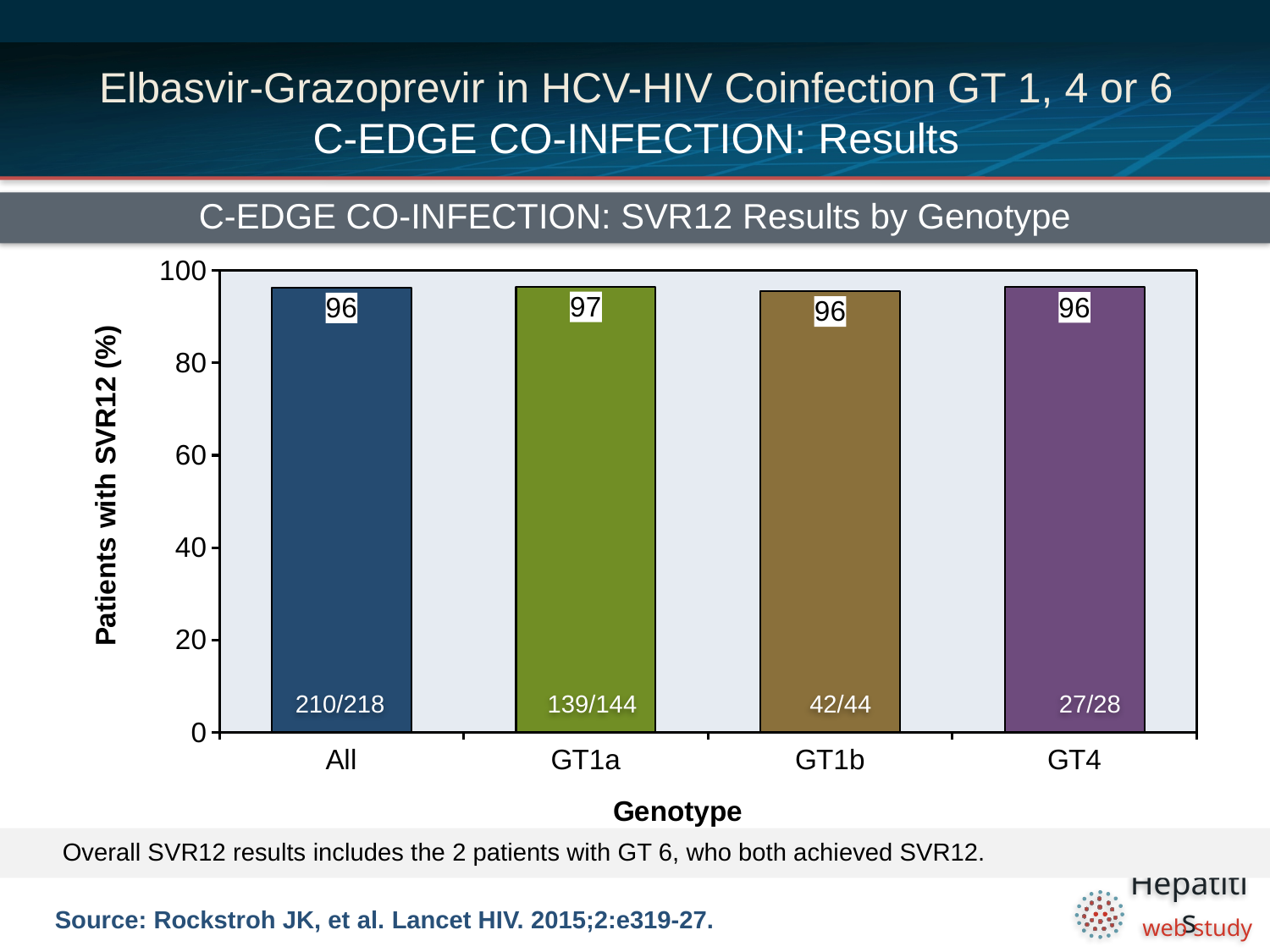
What fraction of patients is printed inside the GT1b bar? 42/44 What is the SVR12 rate shown for the GT1a group? 97 What is the SVR12 rate shown for the All group? 96 What is the label of the y axis? Patients with SVR12 (%) How many genotype groups are shown on the x axis? 4 Which has a higher SVR12 rate, GT1a or GT4? GT1a What is the difference in SVR12 rate between GT1a and GT1b? 1 Is the SVR12 rate for GT1b greater or less than 80? greater Which genotype group has the highest SVR12 rate? GT1a What fraction of patients is printed inside the All bar? 210/218 What is the SVR12 rate shown for the GT4 group? 96 What type of chart is shown on the slide? Bar chart